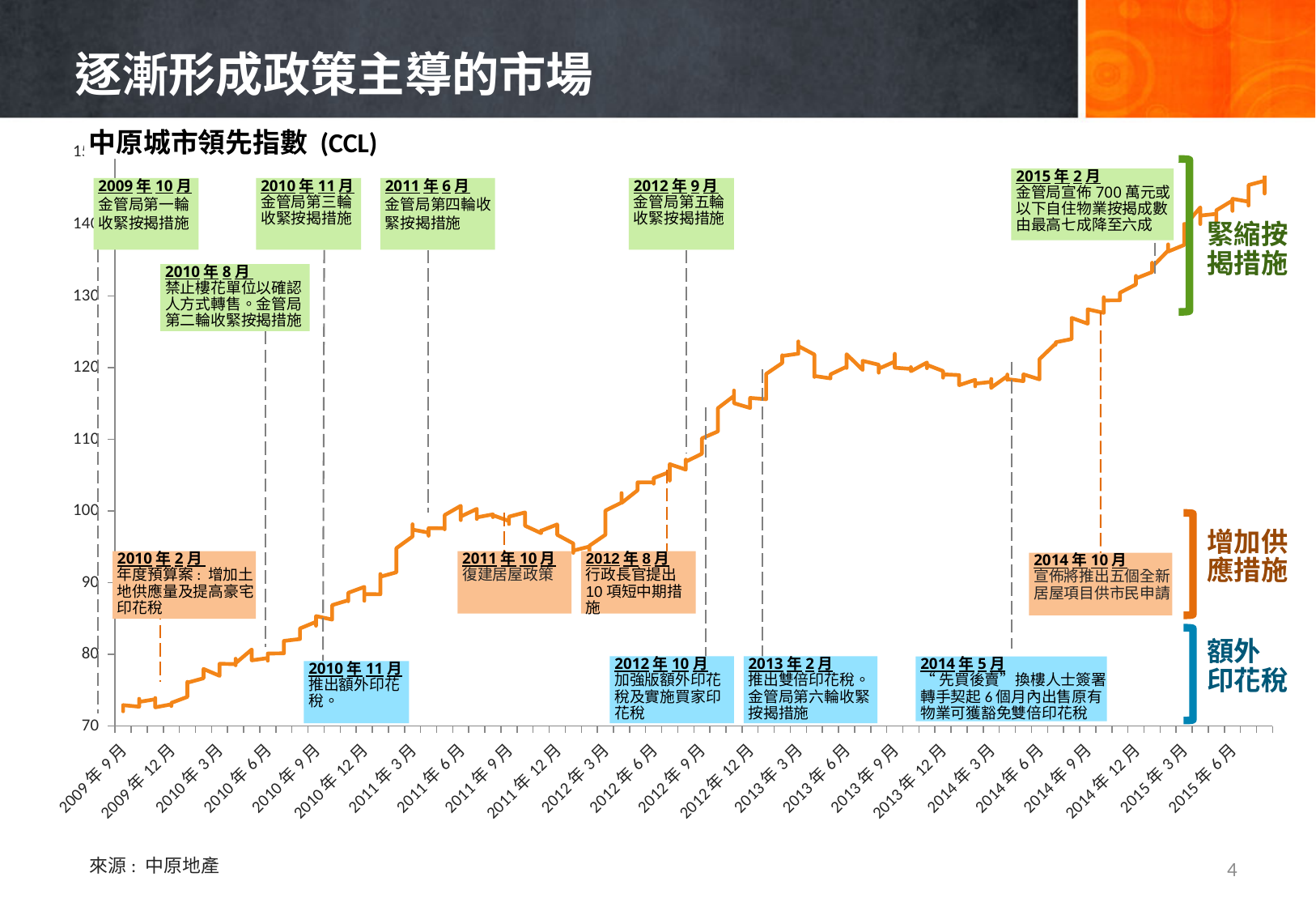
How many x-axis labels are shown on the chart? 24 Overall, does the CCL index rise or fall from 2009年9月 to 2015年6月? rise Is the CCL value at 2009年9月 greater or less than 80? less Is the CCL value at 2010年9月 greater or less than 90? less What is the title of the chart? 中原城市領先指數 (CCL) Around which x-axis label does the CCL index reach its lowest value? 2009年9月 Is the CCL value at 2012年9月 greater or less than 100? greater Which is higher, the CCL value at 2012年3月 or at 2013年3月? 2013年3月 What kind of chart is shown on the slide? line chart Around which x-axis label does the CCL index reach its highest value? 2015年6月